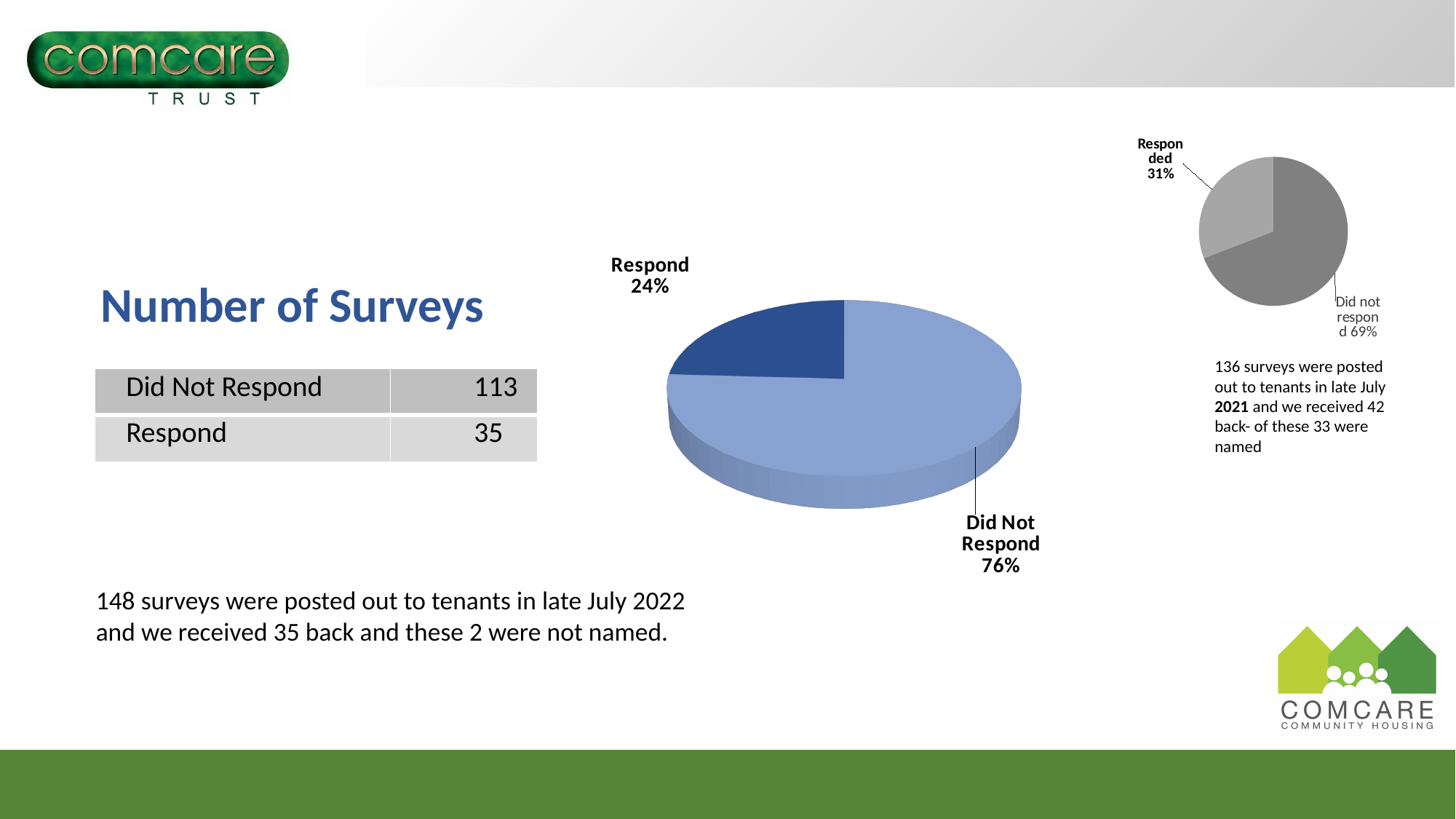
In the large centre pie chart, what is the difference in percentage points between the Did Not Respond and Respond slices? 52 In the large centre pie chart, what share does the Did Not Respond slice have? 76% In the small grey pie chart at the top right, what share does the Responded slice have? 31% In the small grey pie chart at the top right, which slice is larger, Responded or Did not respond? Did not respond In the large centre pie chart, what colour is the Respond slice? dark blue In the large centre pie chart, which slice is the largest? Did Not Respond How many slices does the small grey pie chart at the top right have? 2 How many slices does the large centre pie chart have? 2 In the small grey pie chart at the top right, what share does the Did not respond slice have? 69% In the large centre pie chart, which slice is the smallest? Respond What kind of chart is the large chart in the centre of the slide? pie chart